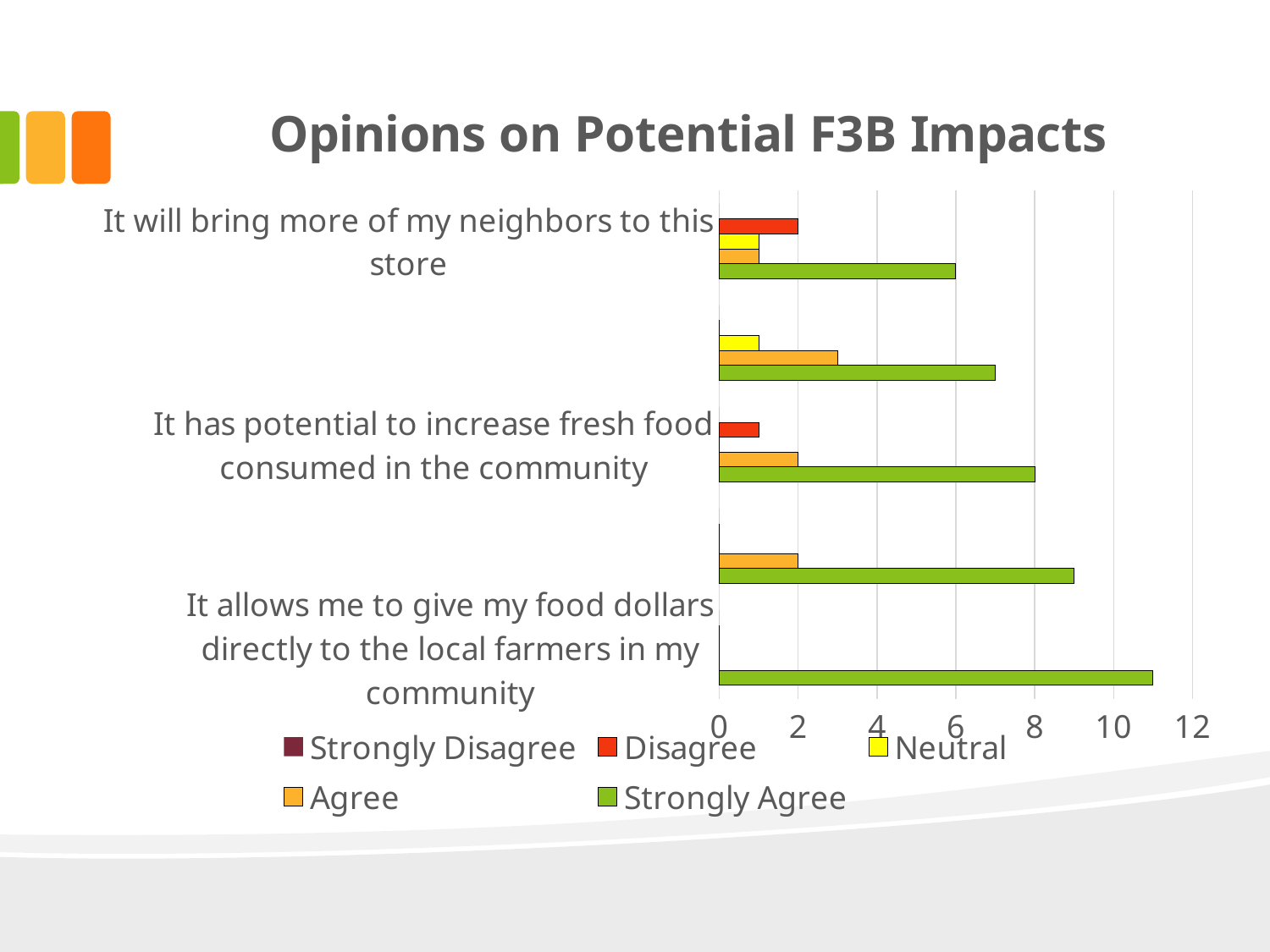
Is the Strongly Agree value for "It allows me to give my food dollars directly to the local farmers in my community" greater or less than 10? greater What is the Agree value for "It has potential to increase fresh food consumed in the community"? 2 What is the Disagree value for "It will bring more of my neighbors to this store"? 2 How many series does the legend list? 5 What is the title of the chart? Opinions on Potential F3B Impacts What is the Strongly Agree value for "It has potential to increase fresh food consumed in the community"? 8 What is the difference between the Strongly Agree values for "It has potential to increase fresh food consumed in the community" and "It will bring more of my neighbors to this store"? 2 Is the Neutral value for "It will bring more of my neighbors to this store" greater or less than 2? less Which labeled statement has the highest Strongly Agree value? It allows me to give my food dollars directly to the local farmers in my community Which has the larger Strongly Agree value: "It has potential to increase fresh food consumed in the community" or "It will bring more of my neighbors to this store"? It has potential to increase fresh food consumed in the community What is the Strongly Agree value for "It will bring more of my neighbors to this store"? 6 What type of chart is shown on the slide? bar chart